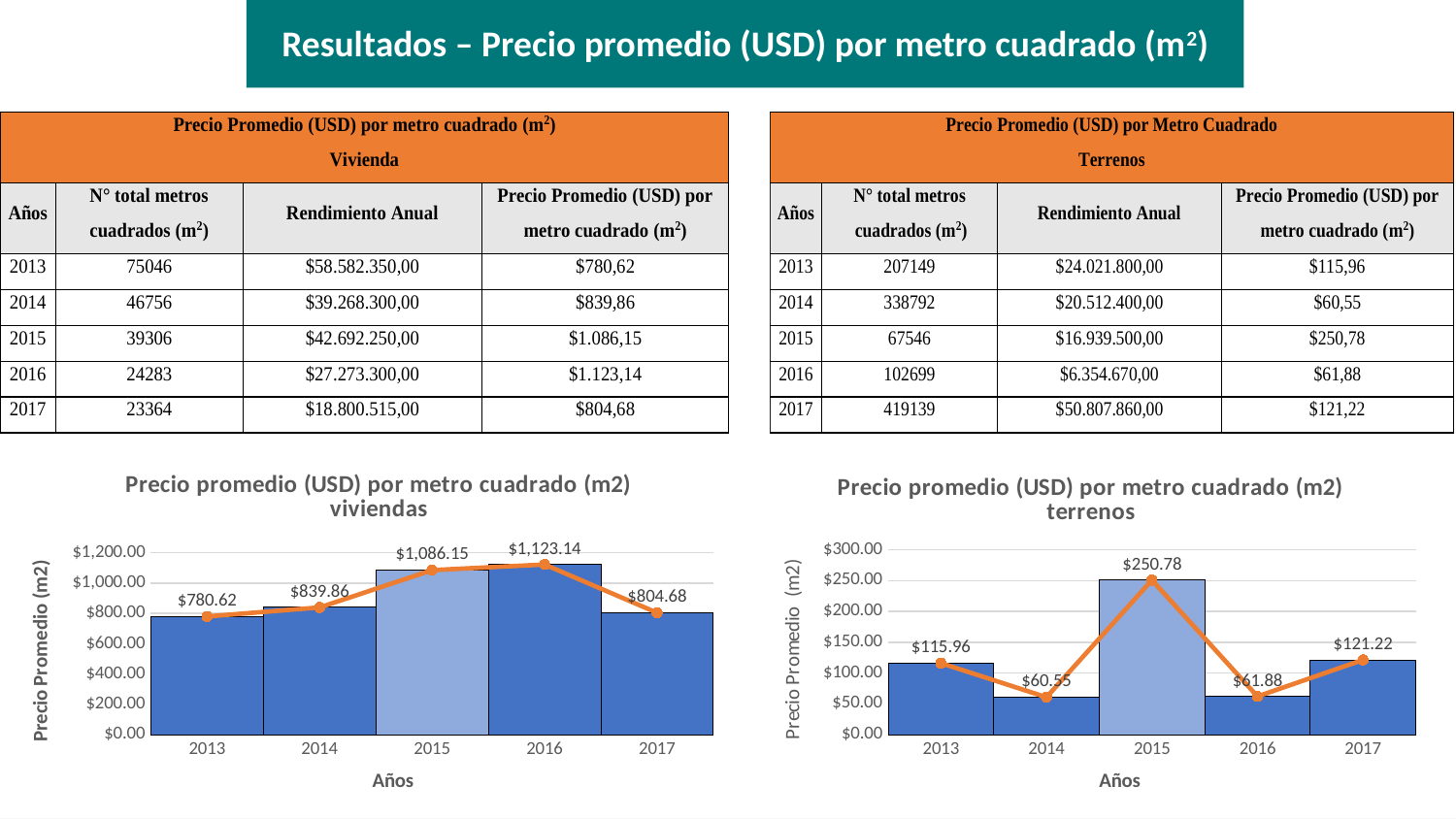
In the viviendas chart, what is the difference between the values for 2016 and 2013? $342.52 In the terrenos chart, what is the difference between the values for 2015 and 2014? $190.23 In the viviendas chart, which year has the lowest value? 2013 In the terrenos chart, which year has the highest value? 2015 In the terrenos chart, what is the value for 2017? $121.22 What is the label on the x axis of the terrenos chart? Años In the terrenos chart, which is larger, the value for 2013 or the value for 2017? 2017 In the viviendas chart, how many years are shown on the x axis? 5 In the viviendas chart, which year has the highest value? 2016 In the viviendas chart, what is the value for 2015? $1,086.15 In the viviendas chart, is the value for 2014 greater or less than $1,000.00? less In the terrenos chart, which year has the lowest value? 2014